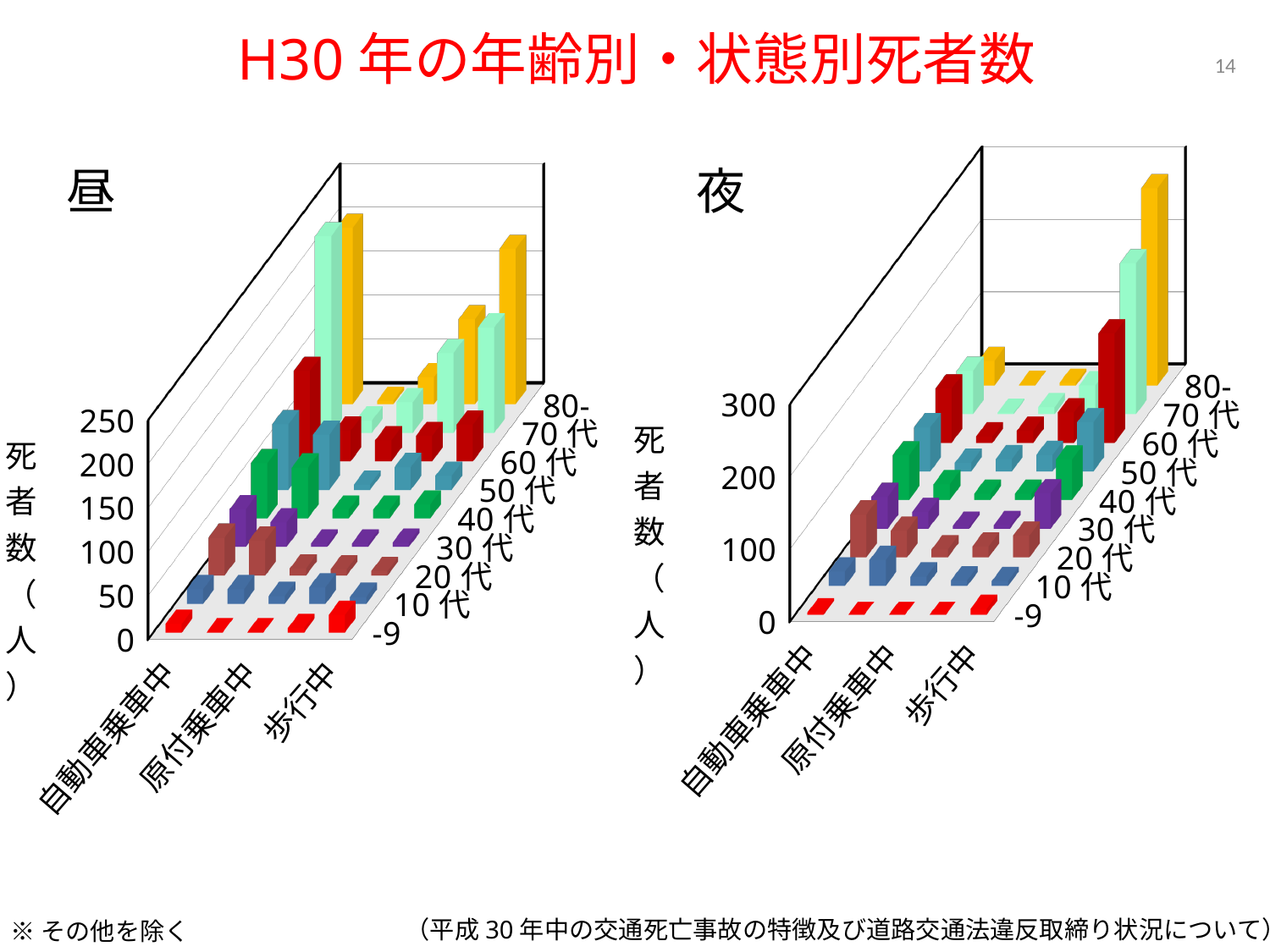
In the 昼 chart, is the value for 歩行中 in the -9 age group greater or less than 50? less What kind of chart is the 昼 chart? bar chart In the 夜 chart, is the value for 自動車乗車中 in the -9 age group greater or less than 100? less How many age groups are shown on the depth axis of the 昼 chart? 9 What is the highest tick value on the vertical axis of the 夜 chart? 300 In the 昼 chart, which is larger for 自動車乗車中: the 80- age group or the -9 age group? 80- In the 昼 chart, is the value for 原付乗車中 in the 30代 age group greater or less than 50? less How many categories are shown on the horizontal axis of the 夜 chart? 3 What is the title of the slide containing the two charts? H30年の年齢別・状態別死者数 In the 夜 chart, which is larger for 歩行中: the 80- age group or the -9 age group? 80-